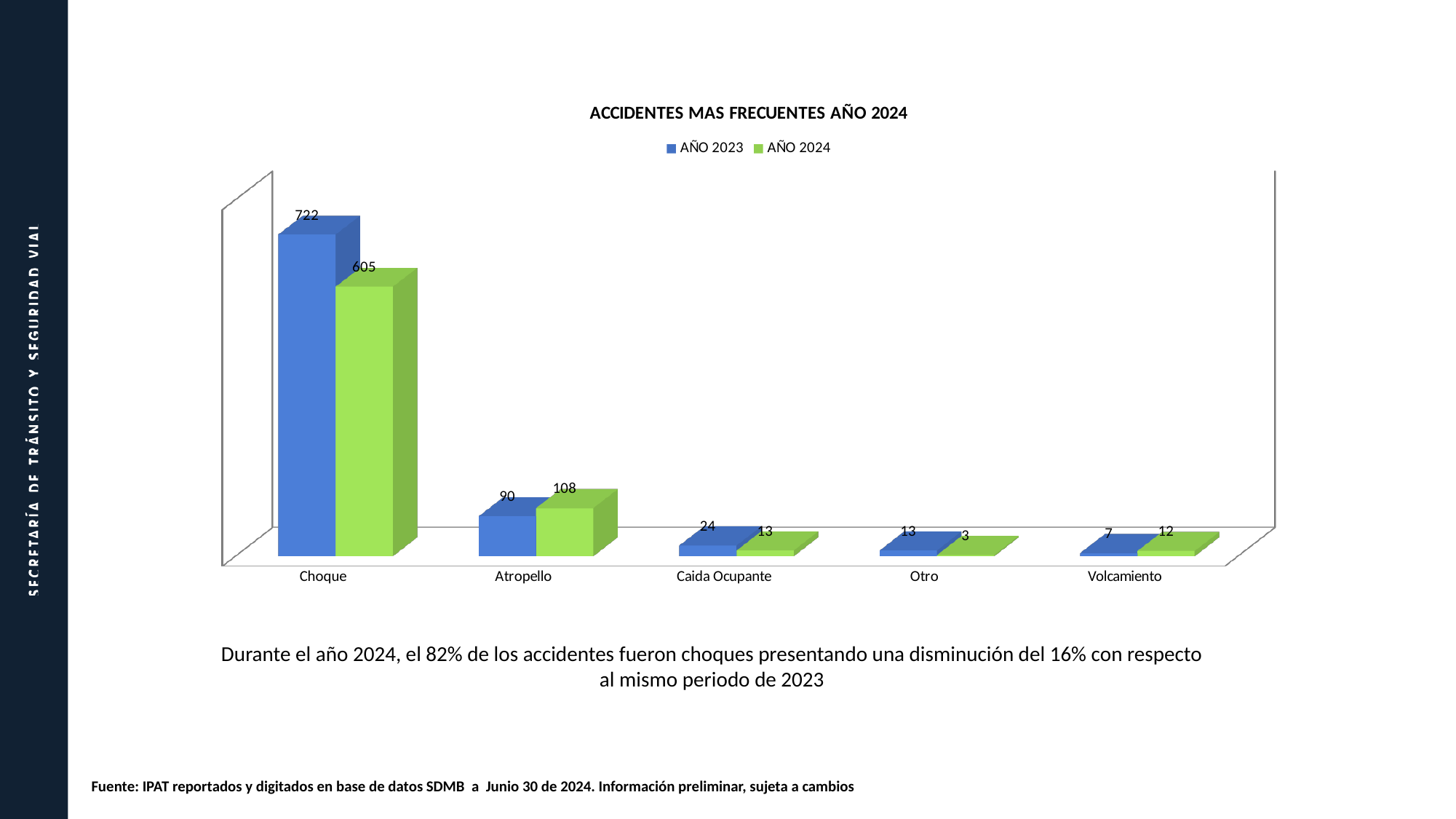
How many categories are shown on the x axis? 5 Which category has the lowest value in the AÑO 2024 series? Otro Which category has the highest value in the AÑO 2023 series? Choque What is the value for Otro in the AÑO 2024 series? 3 How many series does the legend list? 2 What is the value for Choque in the AÑO 2024 series? 605 What kind of chart is shown on the slide? Bar chart What is the difference between the AÑO 2023 and AÑO 2024 values for Choque? 117 Which is larger for Atropello, the AÑO 2023 value or the AÑO 2024 value? AÑO 2024 What is the title of the chart? ACCIDENTES MAS FRECUENTES AÑO 2024 What is the value for Choque in the AÑO 2023 series? 722 What is the value for Atropello in the AÑO 2024 series? 108